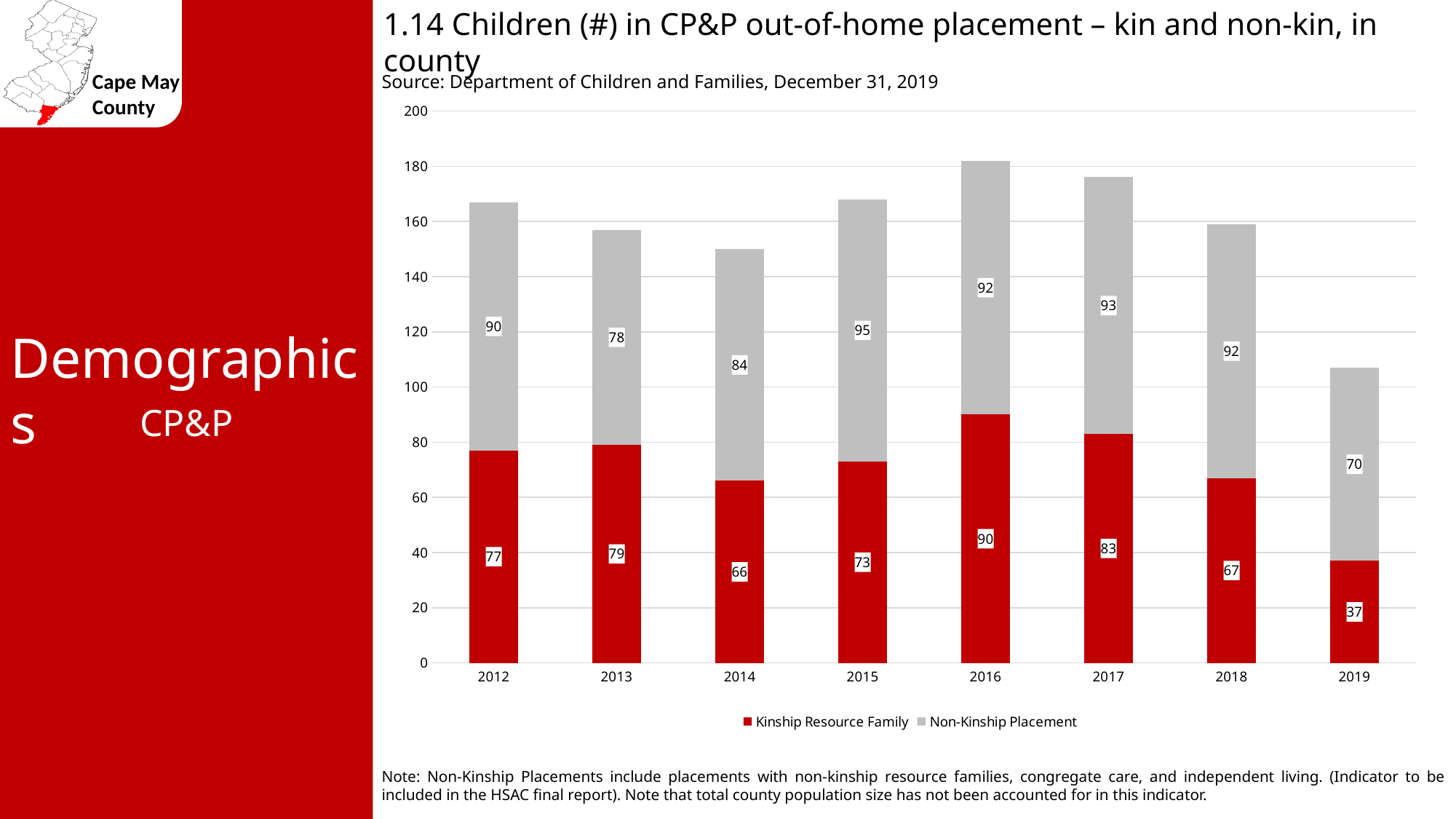
Is the total height of the 2016 stacked bar greater or less than 160? greater What is the difference between the Non-Kinship Placement value and the Kinship Resource Family value in 2019? 33 What is the Kinship Resource Family value for 2016? 90 Which year has the highest Non-Kinship Placement value? 2015 How many series does the legend list? 2 What is the Non-Kinship Placement value for 2015? 95 What kind of chart is shown on the slide? Stacked bar chart Which year has the lowest Kinship Resource Family value? 2019 What is the total of the stacked bar for 2012? 167 Which colour represents Non-Kinship Placement in the chart? Gray How many years are shown on the x axis? 8 Which is larger in 2013: Kinship Resource Family or Non-Kinship Placement? Kinship Resource Family